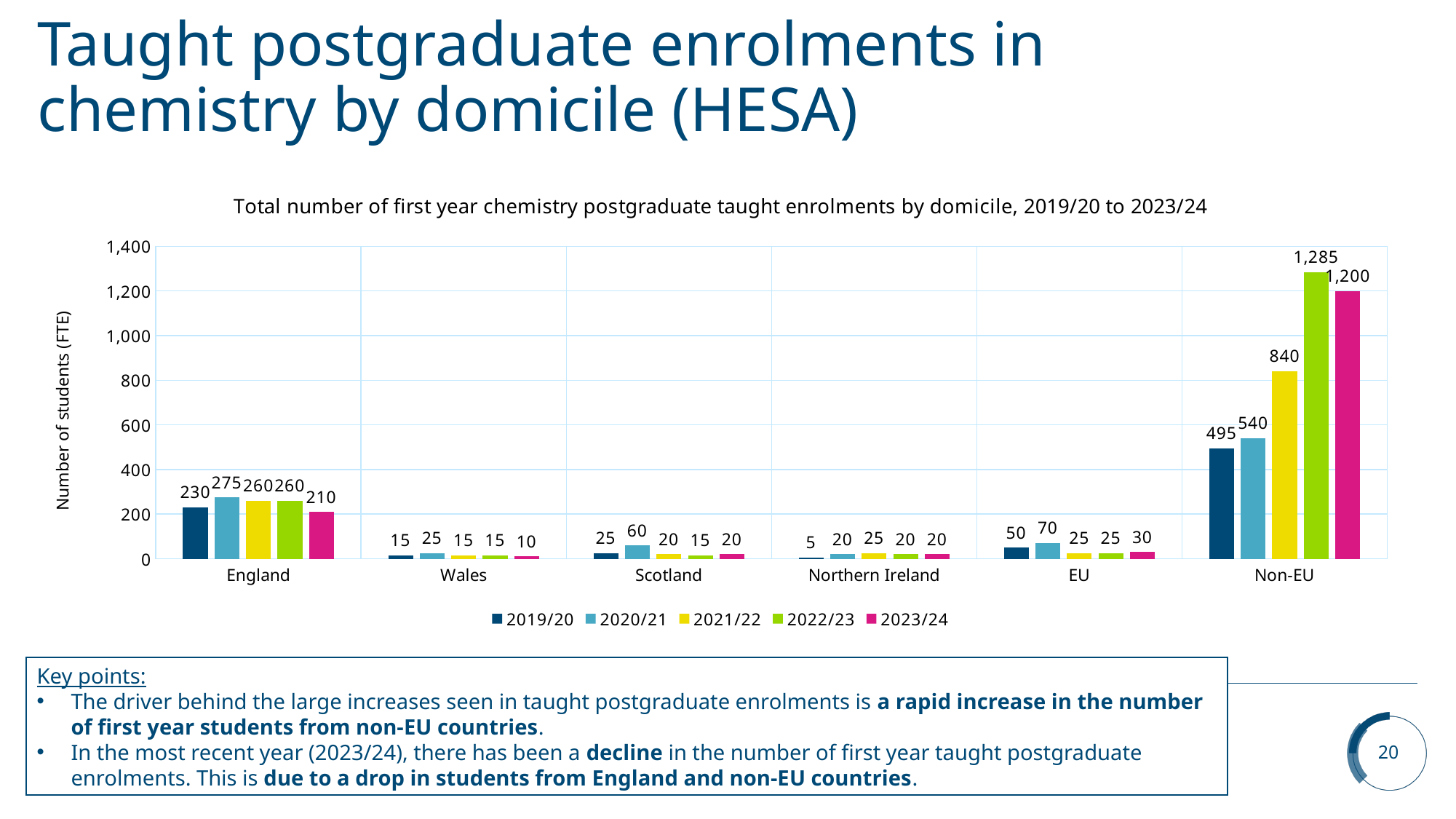
Is the value for Non-EU in 2021/22 greater or less than 1,000? less What is the value for Northern Ireland in 2019/20? 5 What is the difference between the Non-EU values for 2022/23 and 2023/24? 85 How many series does the legend list? 5 Which domicile has the highest value in 2023/24? Non-EU What kind of chart is shown on the slide? Bar chart How many domicile categories are shown on the x axis? 6 What is the value for England in 2020/21? 275 What is the value for Scotland in 2020/21? 60 What is the value for Non-EU in 2022/23? 1,285 Which is larger: the EU value for 2020/21 or the Scotland value for 2020/21? EU value for 2020/21 Which year has the lowest value for Wales? 2023/24